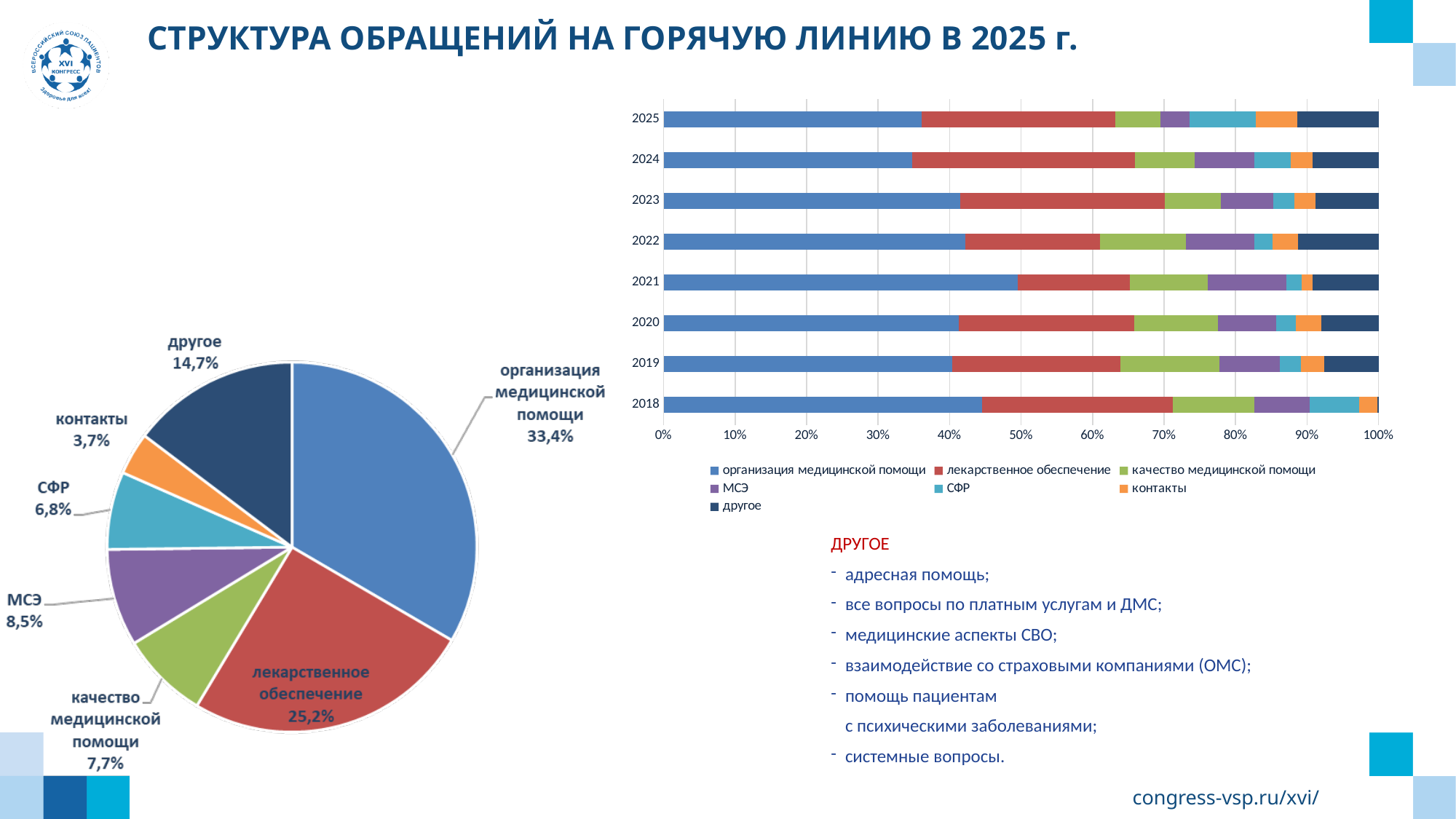
In the pie chart on the left, what is the difference between the shares of 'организация медицинской помощи' and 'лекарственное обеспечение'? 8,2% In the pie chart on the left, which category has the smallest share? контакты What type of chart is shown on the right side of the slide? Stacked bar chart In the pie chart on the left, what is the value for 'СФР'? 6,8% In the pie chart on the left, what share of requests is for 'организация медицинской помощи'? 33,4% How many series does the legend of the bar chart on the right list? 7 How many years are shown in the bar chart on the right? 8 How many slices does the pie chart on the left have? 7 In the pie chart on the left, which category has the largest share? организация медицинской помощи In the pie chart on the left, which is larger: 'МСЭ' or 'качество медицинской помощи'? МСЭ In the bar chart on the right, is the value for 'организация медицинской помощи' in 2021 greater or less than 40%? greater In the pie chart on the left, what share of requests is for 'лекарственное обеспечение'? 25,2%